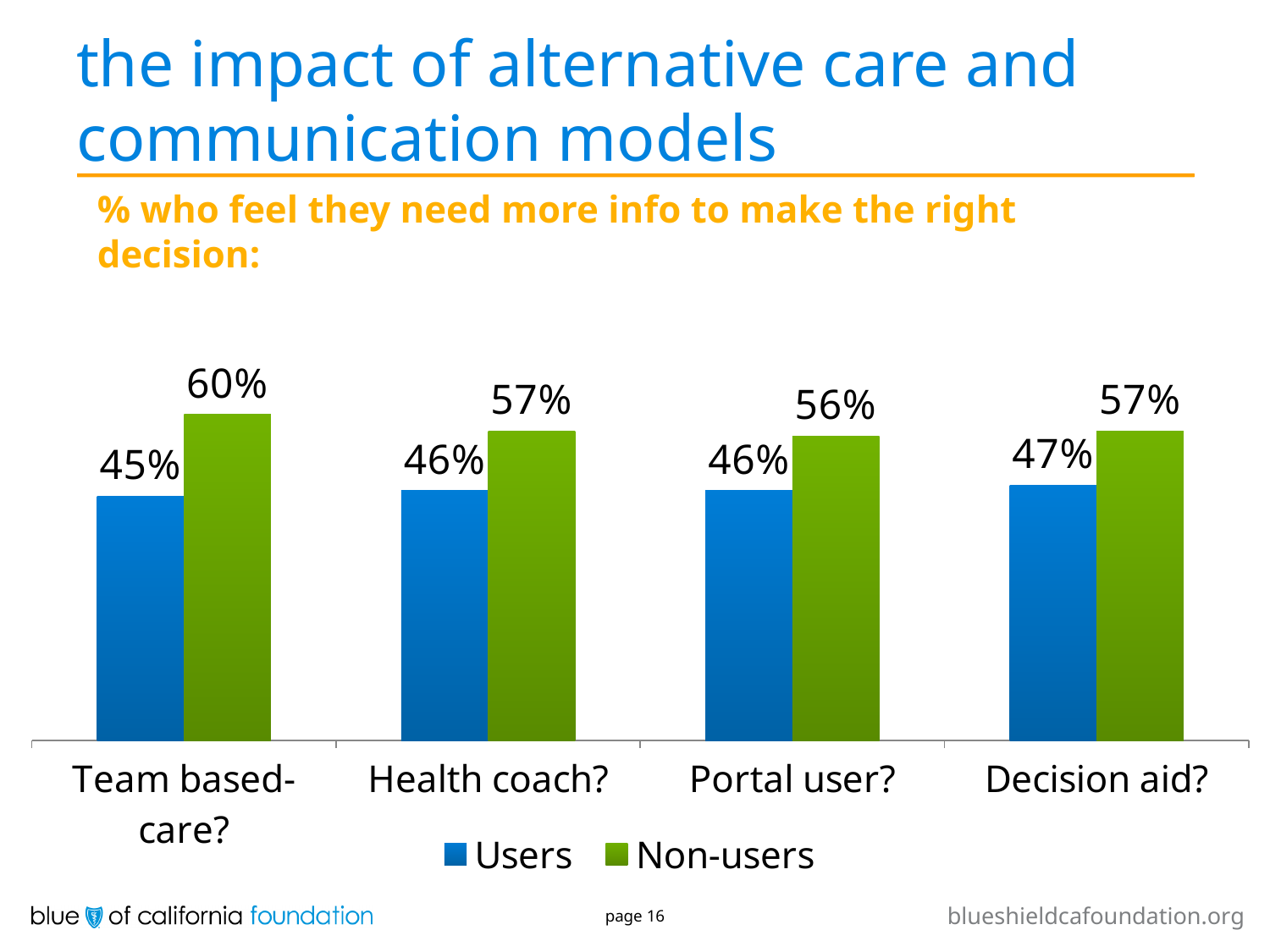
What is the Non-users value for Portal user? 56% What is the difference between Non-users and Users for Health coach? 11% What is the Users value for Decision aid? 47% Which category has the highest Non-users value? Team based-care? How many categories are shown on the x axis? 4 How many series does the legend list? 2 What is the difference between Non-users and Users for Team based-care? 15% Which category has the lowest Users value? Team based-care? For Decision aid, which is larger: Users or Non-users? Non-users Which colour represents Non-users in the chart? Green What percentage of Users feel they need more info for Team based-care? 45% What kind of chart is shown on the slide? Bar chart